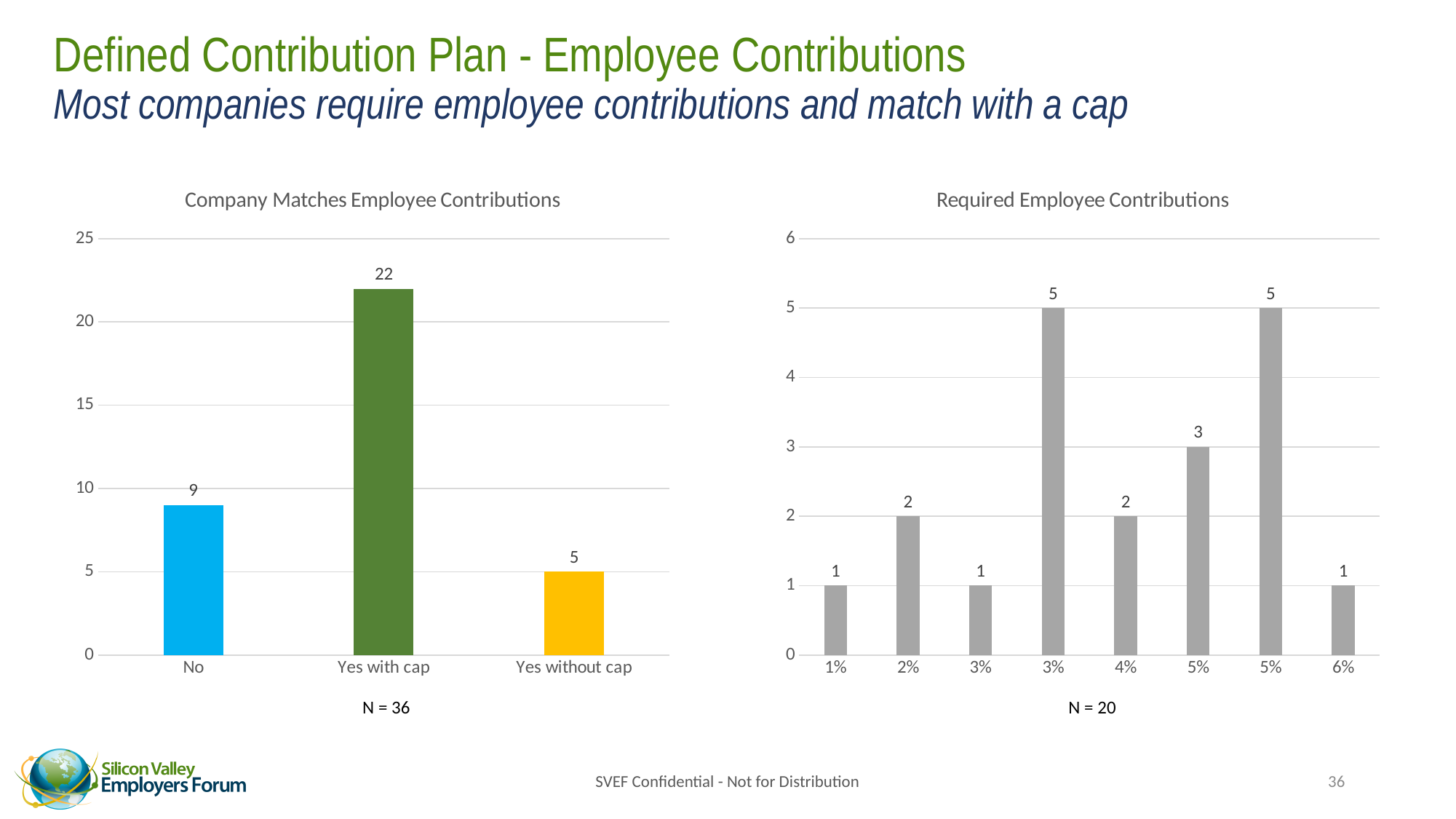
In the 'Company Matches Employee Contributions' chart, what is the value for 'Yes with cap'? 22 In the 'Company Matches Employee Contributions' chart, which category has the lowest value? Yes without cap In the 'Required Employee Contributions' chart, what is the value for the '2%' category? 2 In the 'Company Matches Employee Contributions' chart, what is the difference between 'Yes with cap' and 'No'? 13 In the 'Required Employee Contributions' chart, how many bars are shown? 8 In the 'Required Employee Contributions' chart, what is the value for the '6%' category? 1 What is the N value shown below the 'Required Employee Contributions' chart? N = 20 In the 'Company Matches Employee Contributions' chart, what is the value for 'No'? 9 What kind of chart is the 'Required Employee Contributions' chart? Bar chart In the 'Company Matches Employee Contributions' chart, which category has the highest value? Yes with cap In the 'Company Matches Employee Contributions' chart, which is larger, 'No' or 'Yes without cap'? No In the 'Company Matches Employee Contributions' chart, how many categories are shown? 3